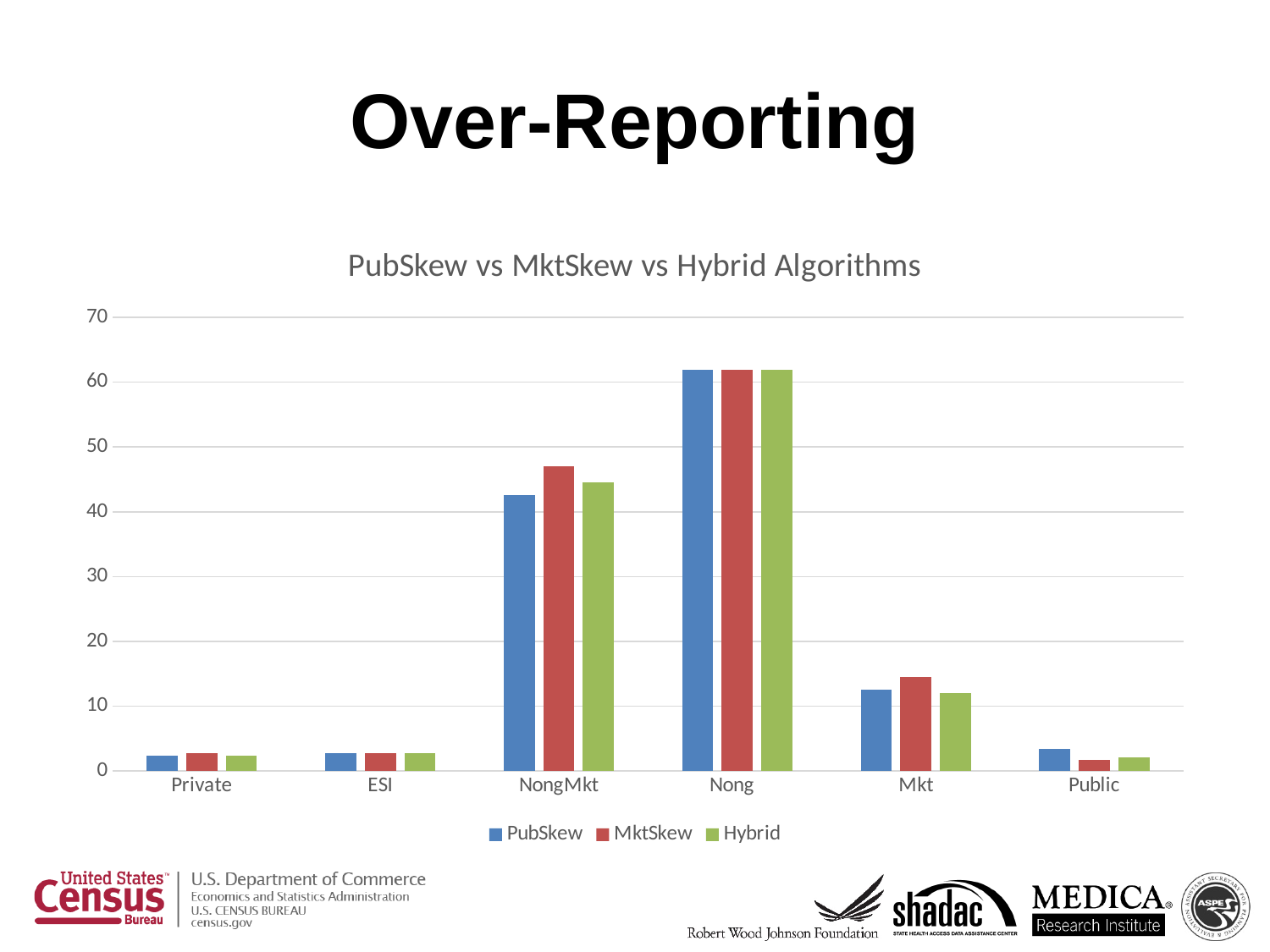
Is the MktSkew value for Mkt greater or less than 10? greater How many categories are shown on the x axis of the chart? 6 Is the MktSkew value for NongMkt greater or less than 40? greater What kind of chart is shown on the slide? bar chart For Public, which is larger: the PubSkew value or the MktSkew value? PubSkew Is the PubSkew value for Public greater or less than 10? less How many series does the chart's legend list? 3 Which category has the lowest MktSkew value? Public Which category has the highest values across all three series? Nong What is the title of the chart? PubSkew vs MktSkew vs Hybrid Algorithms For NongMkt, which is larger: the PubSkew value or the MktSkew value? MktSkew